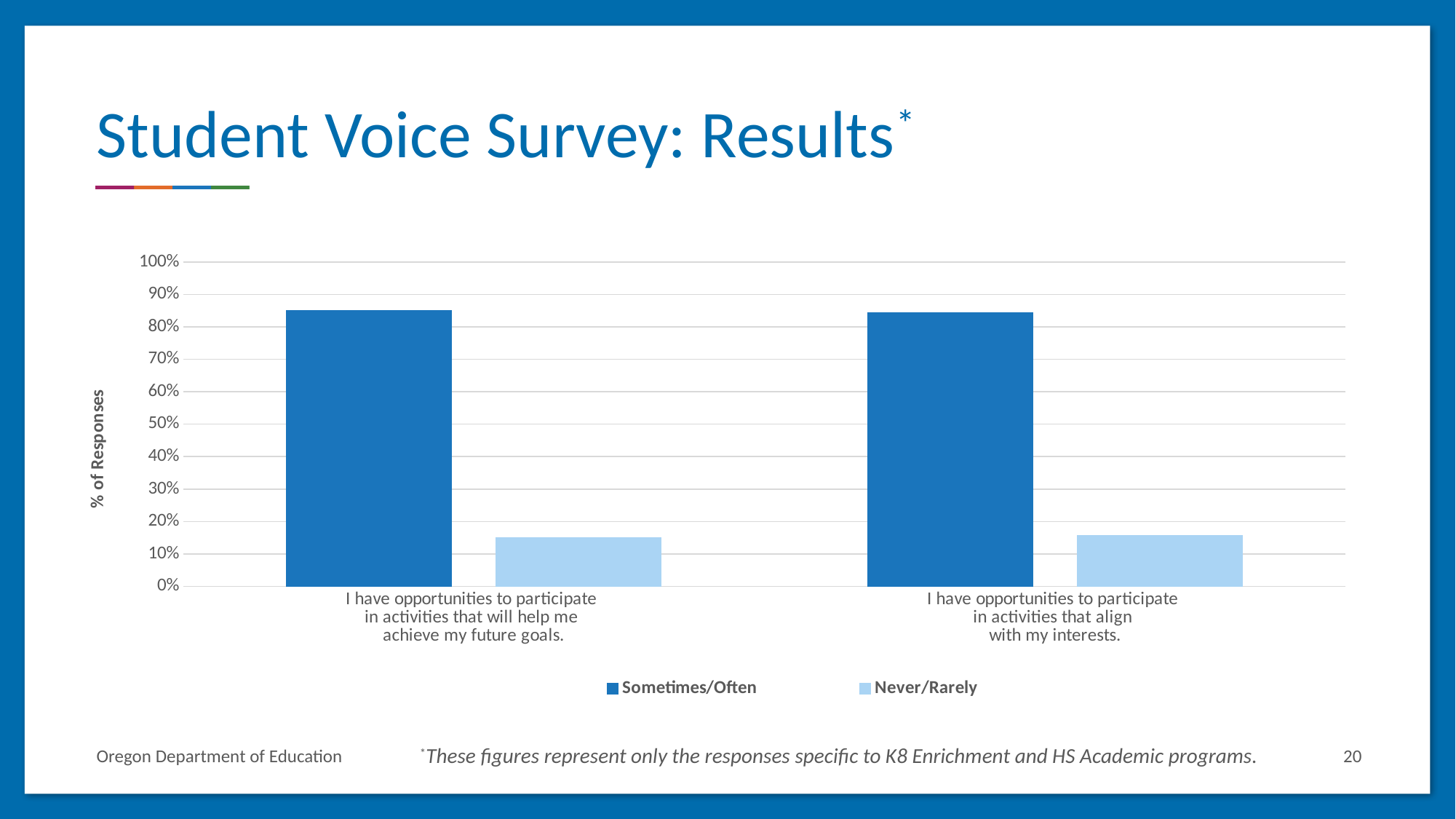
For the statement 'I have opportunities to participate in activities that align with my interests', which series has the smaller value, Sometimes/Often or Never/Rarely? Never/Rarely What kind of chart is shown on the slide? bar chart How many series does the legend list? 2 Is the Never/Rarely value for 'I have opportunities to participate in activities that will help me achieve my future goals' greater or less than 20%? less Is the Sometimes/Often value for 'I have opportunities to participate in activities that will help me achieve my future goals' greater or less than 80%? greater Is the Never/Rarely value for 'I have opportunities to participate in activities that align with my interests' greater or less than 10%? greater What is the label on the vertical axis? % of Responses Which series is listed first in the legend? Sometimes/Often How many survey statements (categories) are shown on the x axis? 2 For the statement 'I have opportunities to participate in activities that will help me achieve my future goals', which series has the larger value, Sometimes/Often or Never/Rarely? Sometimes/Often